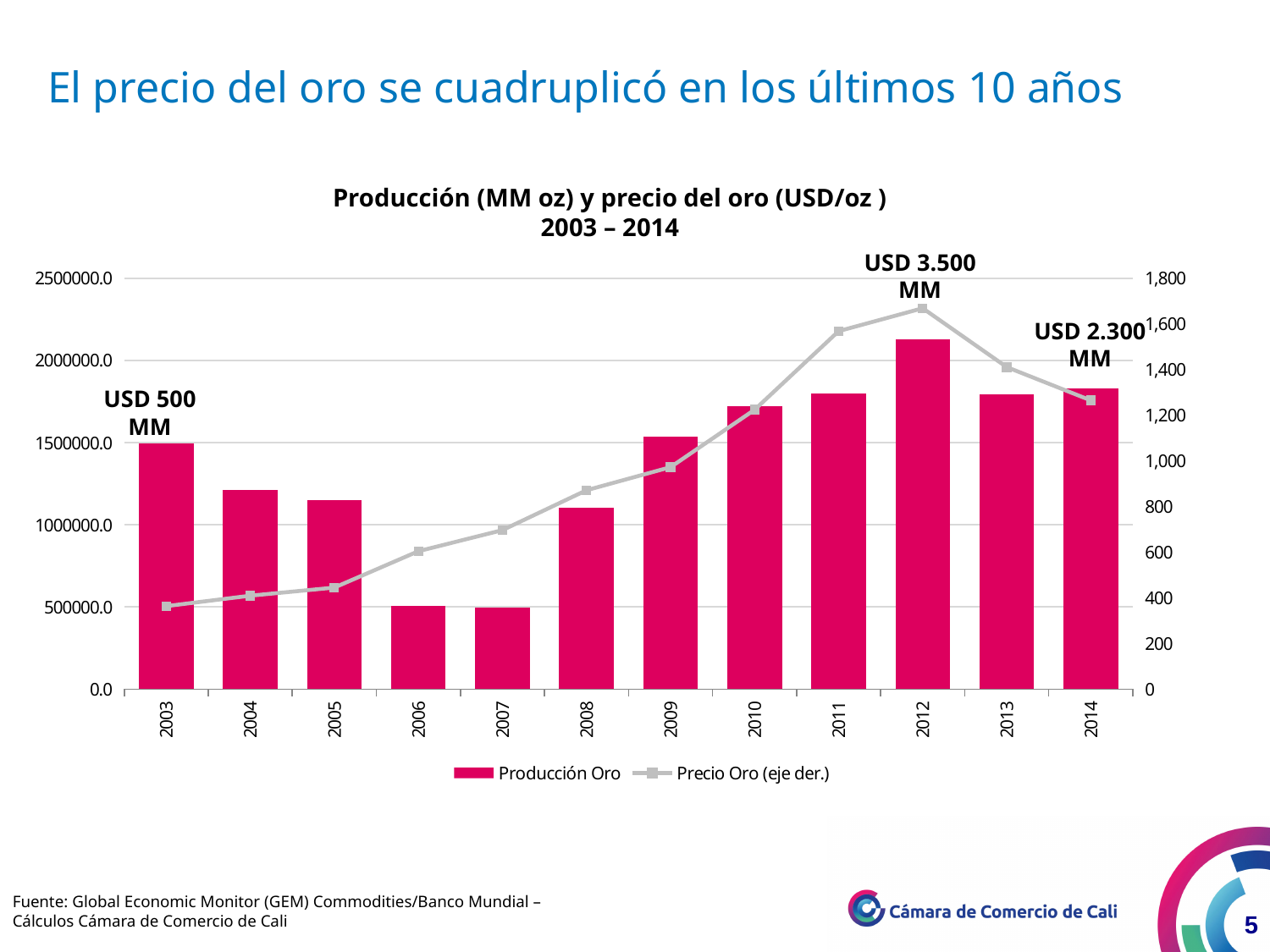
Is the Precio Oro value for 2014 greater or less than 1,000 on the right axis? greater Is the Precio Oro value for 2003 greater or less than 600 on the right axis? less What are the two entries in the chart legend? Producción Oro and Precio Oro (eje der.) How many years are shown on the x axis of the chart? 12 Is the Producción Oro value for 2012 greater or less than 2000000.0? greater What kind of chart is shown on the slide? A combined bar and line chart How many series does the chart legend list? 2 Which year has the larger Producción Oro bar, 2008 or 2011? 2011 In which year does the Precio Oro line reach its highest point? 2012 Does the Precio Oro line rise or fall between 2003 and 2012? It rises Which year has the highest Producción Oro bar? 2012